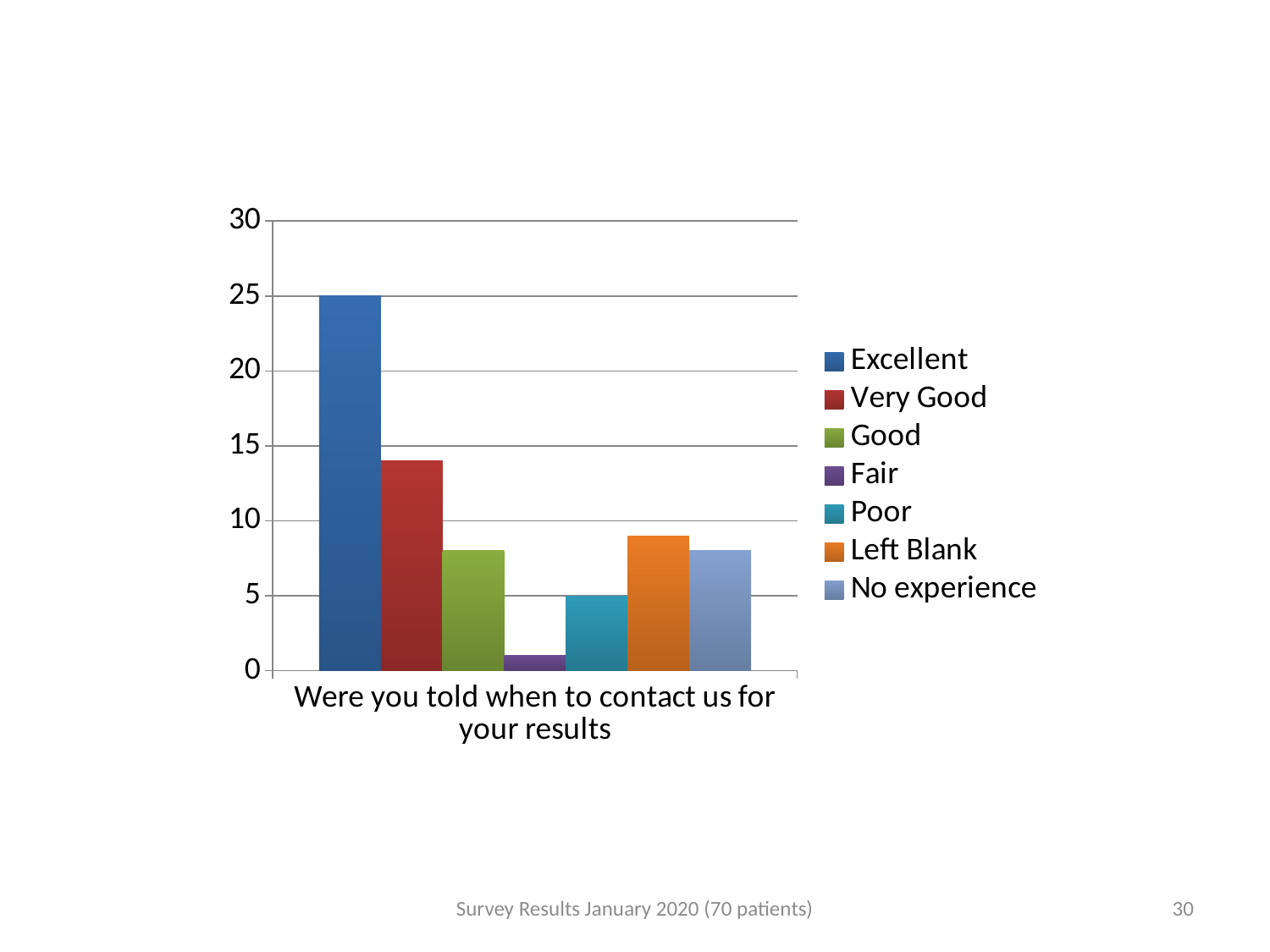
What is the value for Poor? 5 Which response has the highest value? Excellent Which response has the lowest value? Fair What type of chart is shown on the slide? bar chart Which is larger, the value for Very Good or the value for Good? Very Good What is the value for Excellent? 25 How many series does the legend list? 7 How many categories are shown on the x axis? 1 Is the value for Fair greater or less than 5? less What is the category label shown on the x axis? Were you told when to contact us for your results Is the value for Very Good greater or less than 10? greater What is the difference between the values for Excellent and Poor? 20